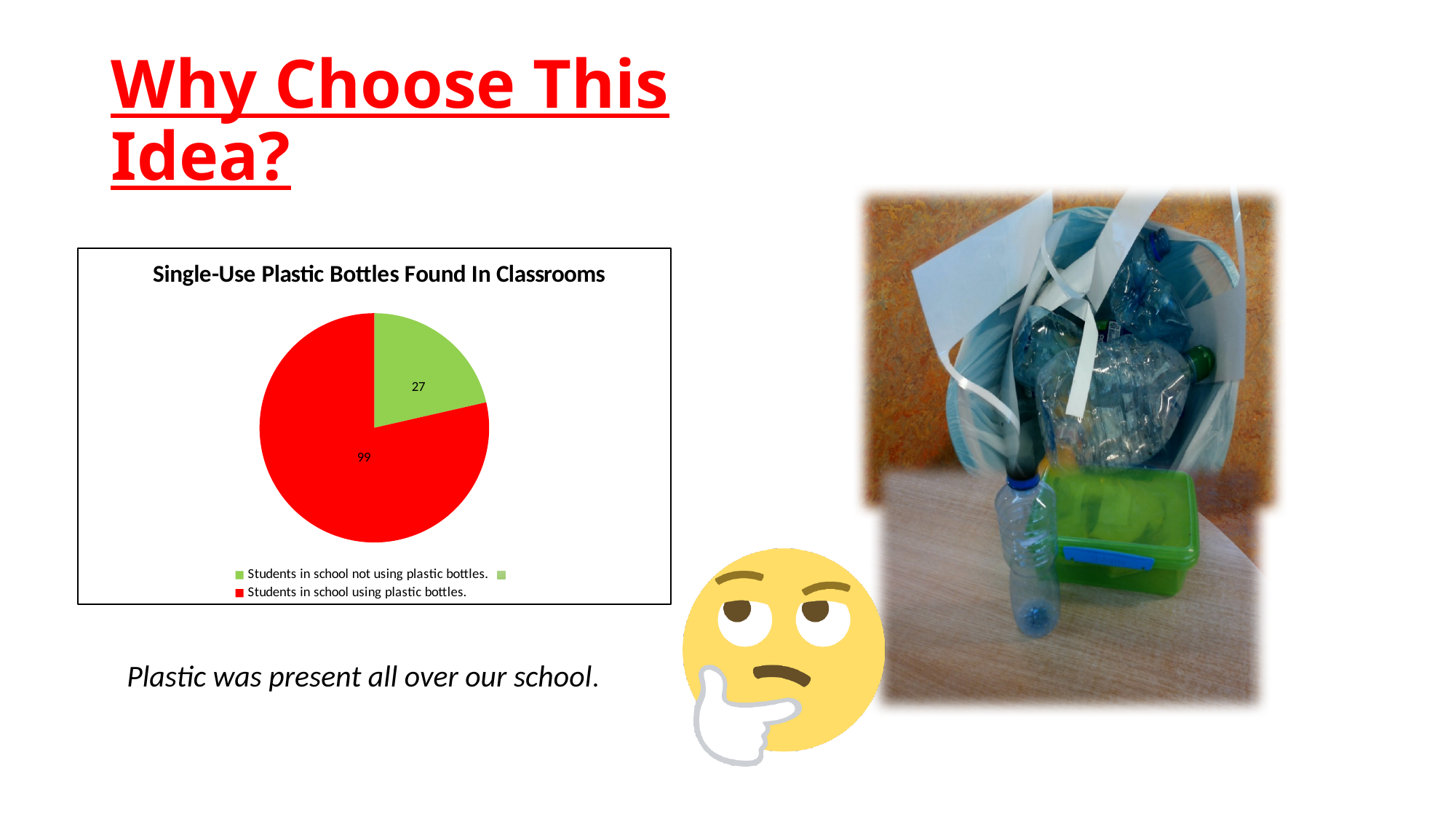
What is the total of the two values shown in the pie chart? 126 Which is larger: the value for students using plastic bottles or the value for students not using plastic bottles? Students using plastic bottles Which category has the smallest slice of the pie? Students in school not using plastic bottles. Which category has the largest slice of the pie? Students in school using plastic bottles. How many categories are listed in the chart's legend? 2 What is the title of the chart? Single-Use Plastic Bottles Found In Classrooms What is the difference between the number of students using plastic bottles and those not using them? 72 Which colour represents students in school not using plastic bottles? Green What is the value for students in school not using plastic bottles? 27 What is the value for students in school using plastic bottles? 99 How many slices does the pie chart have? 2 What type of chart is shown on the slide? Pie chart